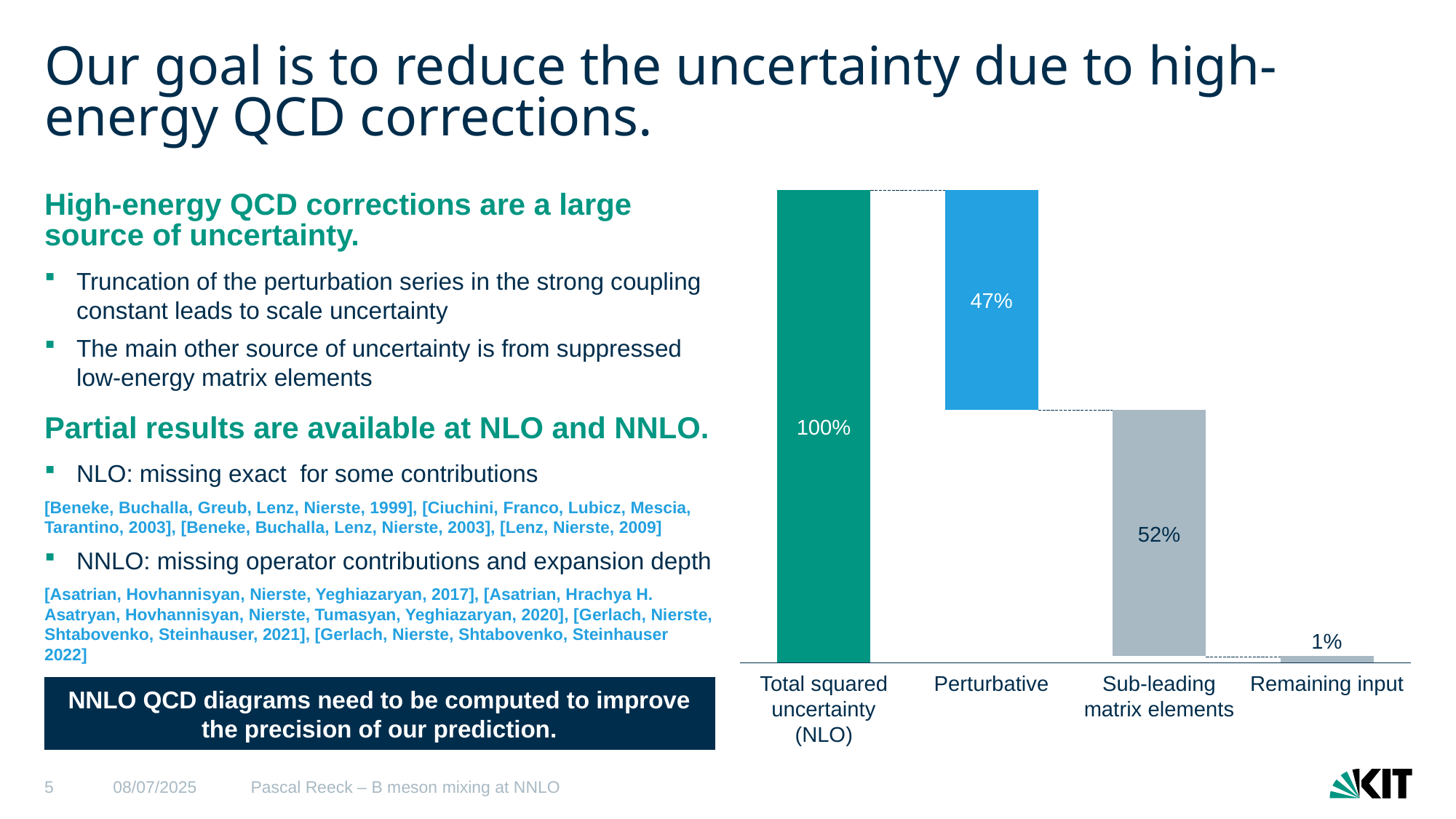
Which is larger, the value for Sub-leading matrix elements or the value for Perturbative? Sub-leading matrix elements How many categories are shown on the x axis of the chart? 4 What kind of chart is shown on the slide? Bar chart Which category has the lowest value in the chart? Remaining input What is the value shown for Sub-leading matrix elements in the chart? 52% Which category has the highest value in the chart? Total squared uncertainty (NLO) What is the difference between the values for Sub-leading matrix elements and Perturbative? 5% What is the difference between the values for Perturbative and Remaining input? 46% What is the value shown for Remaining input in the chart? 1% What is the value shown for Perturbative in the chart? 47% What is the value shown for Total squared uncertainty (NLO) in the chart? 100% What colour is the bar for Perturbative? Blue